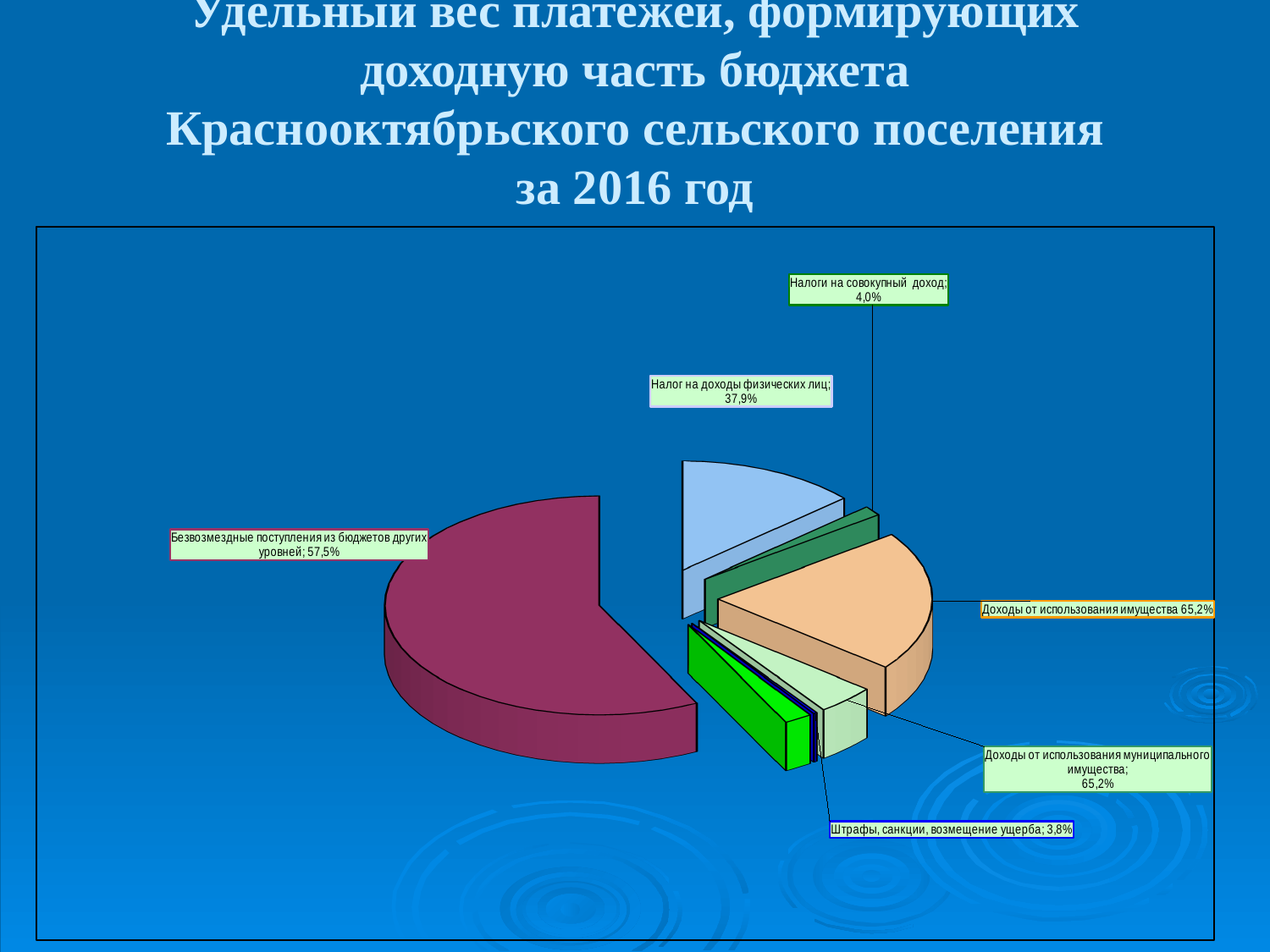
Which year does the chart title refer to? 2016 What is the value shown for Штрафы, санкции, возмещение ущерба? 3,8% What is the value shown for Доходы от использования муниципального имущества? 65,2% What is the value shown for Безвозмездные поступления из бюджетов других уровней? 57,5% What is the difference in percentage points between Налог на доходы физических лиц and Налоги на совокупный доход? 33,9 What kind of chart is shown on the slide? Pie chart What is the difference in percentage points between Безвозмездные поступления из бюджетов других уровней and Налог на доходы физических лиц? 19,6 What is the value shown for Налоги на совокупный доход? 4,0% Which is larger: Налог на доходы физических лиц or Налоги на совокупный доход? Налог на доходы физических лиц Which labelled category has the lowest printed value? Штрафы, санкции, возмещение ущерба What is the value shown for Налог на доходы физических лиц? 37,9% What colour is the slice for Безвозмездные поступления из бюджетов других уровней? Maroon (dark purple-red)